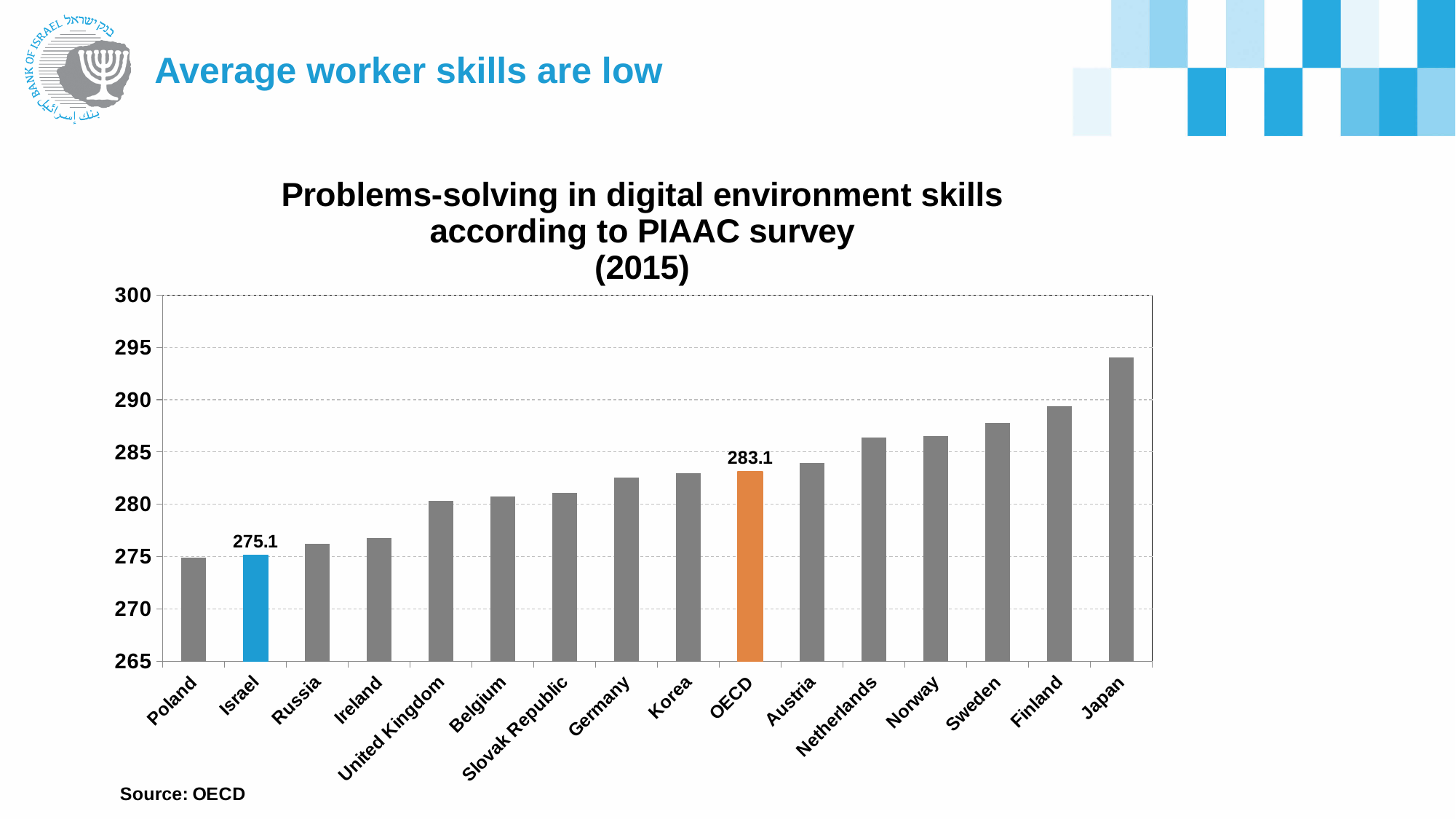
What is the value for Israel? 275.1 Which is larger, the value for Israel or the value for OECD? OECD Which country has the highest value? Japan How many bars are shown in the chart? 16 What kind of chart is shown? bar chart Which is larger, the value for Japan or the value for Finland? Japan Do the values rise or fall from left to right along the x axis? rise What is the value for OECD? 283.1 Is the value for Netherlands greater or less than 285? greater What is the difference between the OECD value and the Israel value? 8.0 Is the value for Russia greater or less than 280? less Is the value for Japan greater or less than 290? greater